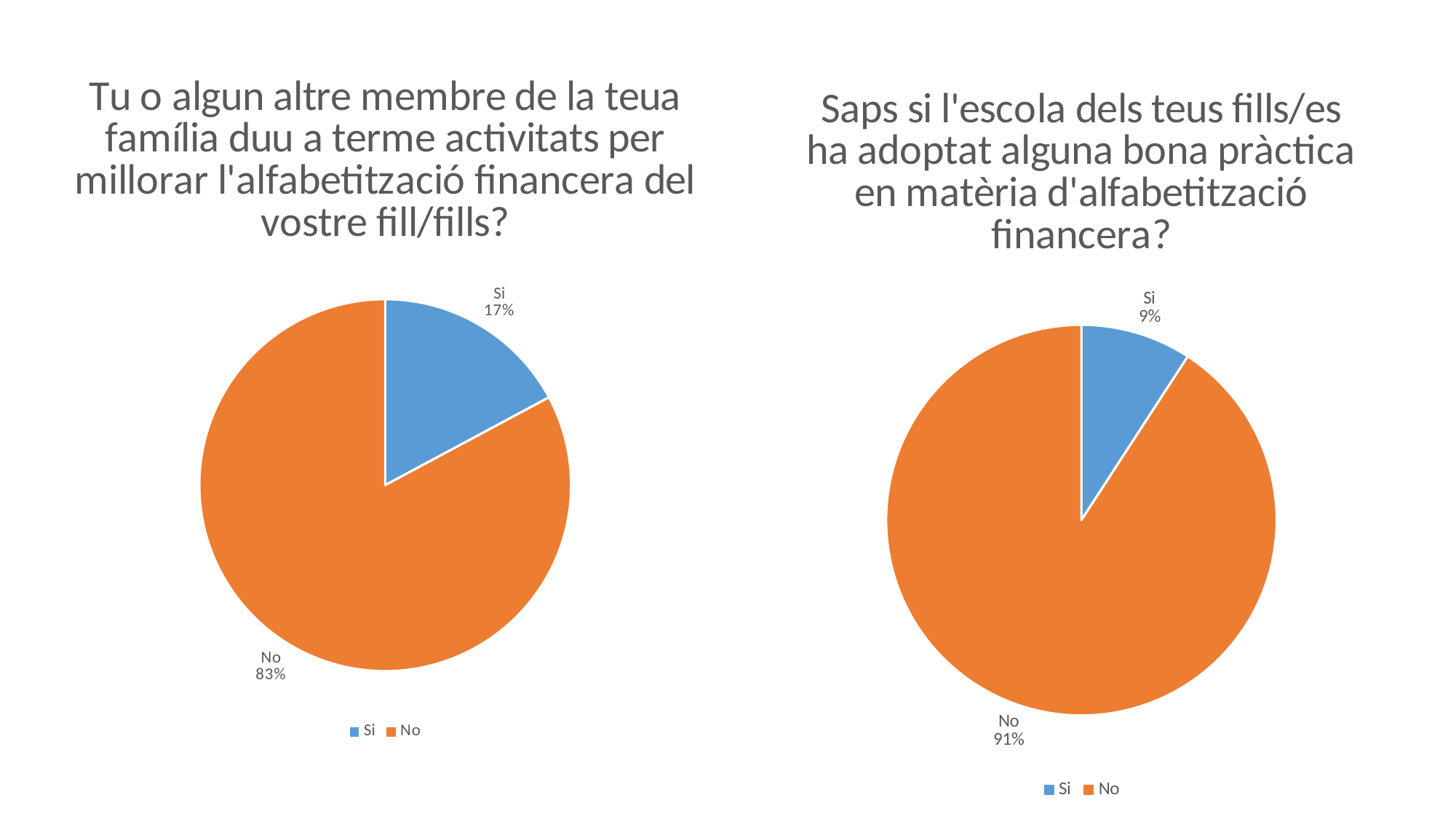
In the left pie chart, what share of responses is 'Si'? 17% Which chart has the larger 'Si' share, the left pie chart or the right pie chart? the left pie chart In the left pie chart, which category has the largest slice? No In the right pie chart, what is the difference in percentage points between 'No' and 'Si'? 82 In the left pie chart, what share of responses is 'No'? 83% In the right pie chart, what share of responses is 'No'? 91% In the left pie chart, what colour is the 'No' slice? orange In the left pie chart, what is the difference in percentage points between 'No' and 'Si'? 66 In the right pie chart, which category has the smallest slice? Si What kind of chart is the left chart? pie chart In the right pie chart, what share of responses is 'Si'? 9% How many categories does the right pie chart show? 2